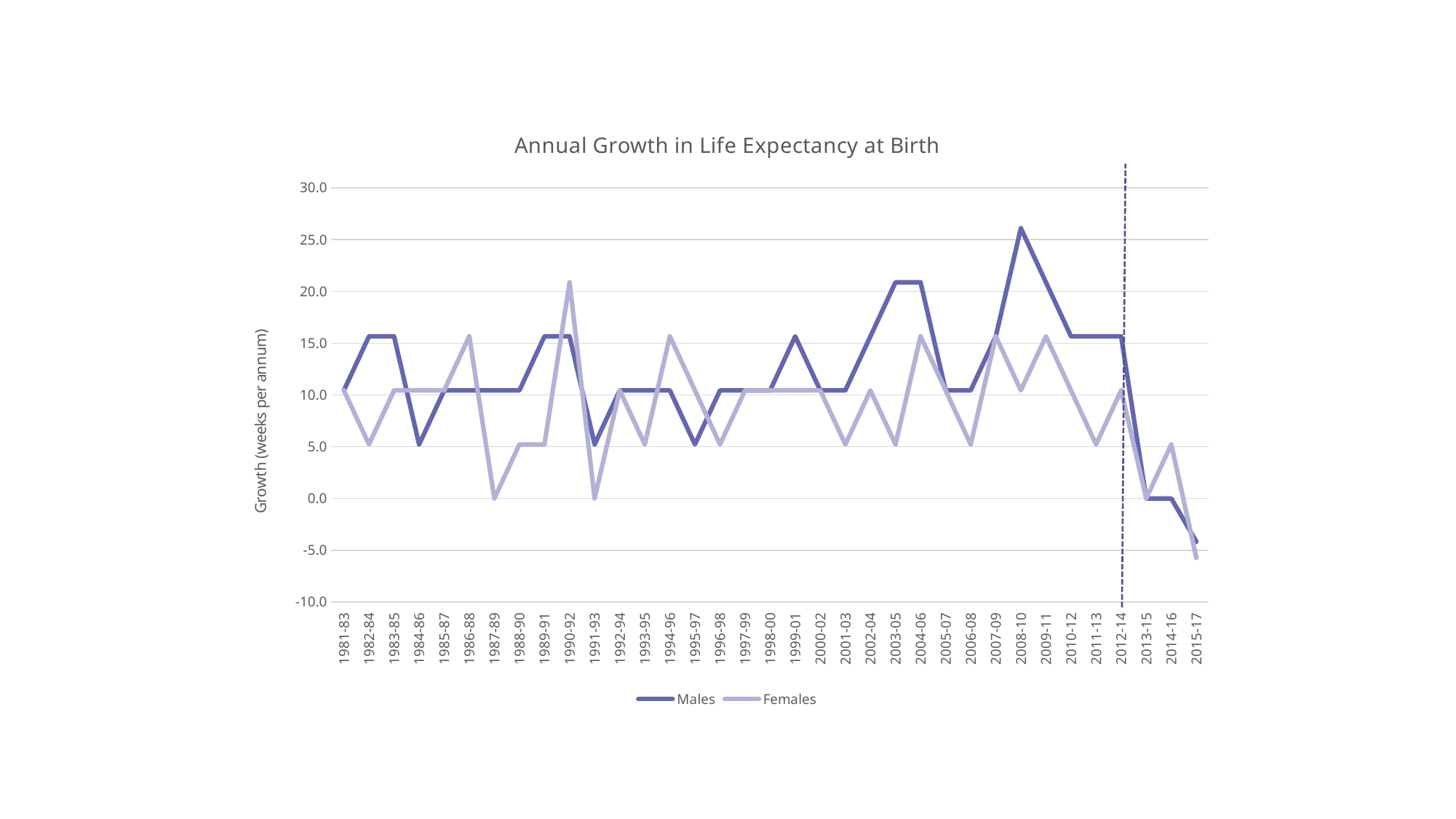
In which period does the Females series reach its highest value? 1990-92 What kind of chart is shown on the slide? line chart Is the value for Females in 1987-89 greater or less than 5.0? less Is the value for Males in 2003-05 greater or less than 15.0? greater In which period does the Males series reach its highest value? 2008-10 In which period does the Males series reach its lowest value? 2015-17 Is the value for Males in 2008-10 greater or less than 20.0? greater How many periods are plotted along the x axis? 35 Do the Males values rise or fall from 2011-13 to 2015-17? fall What is the label on the vertical axis? Growth (weeks per annum) How many series does the legend list? 2 In 1990-92, which series has the larger value, Males or Females? Females